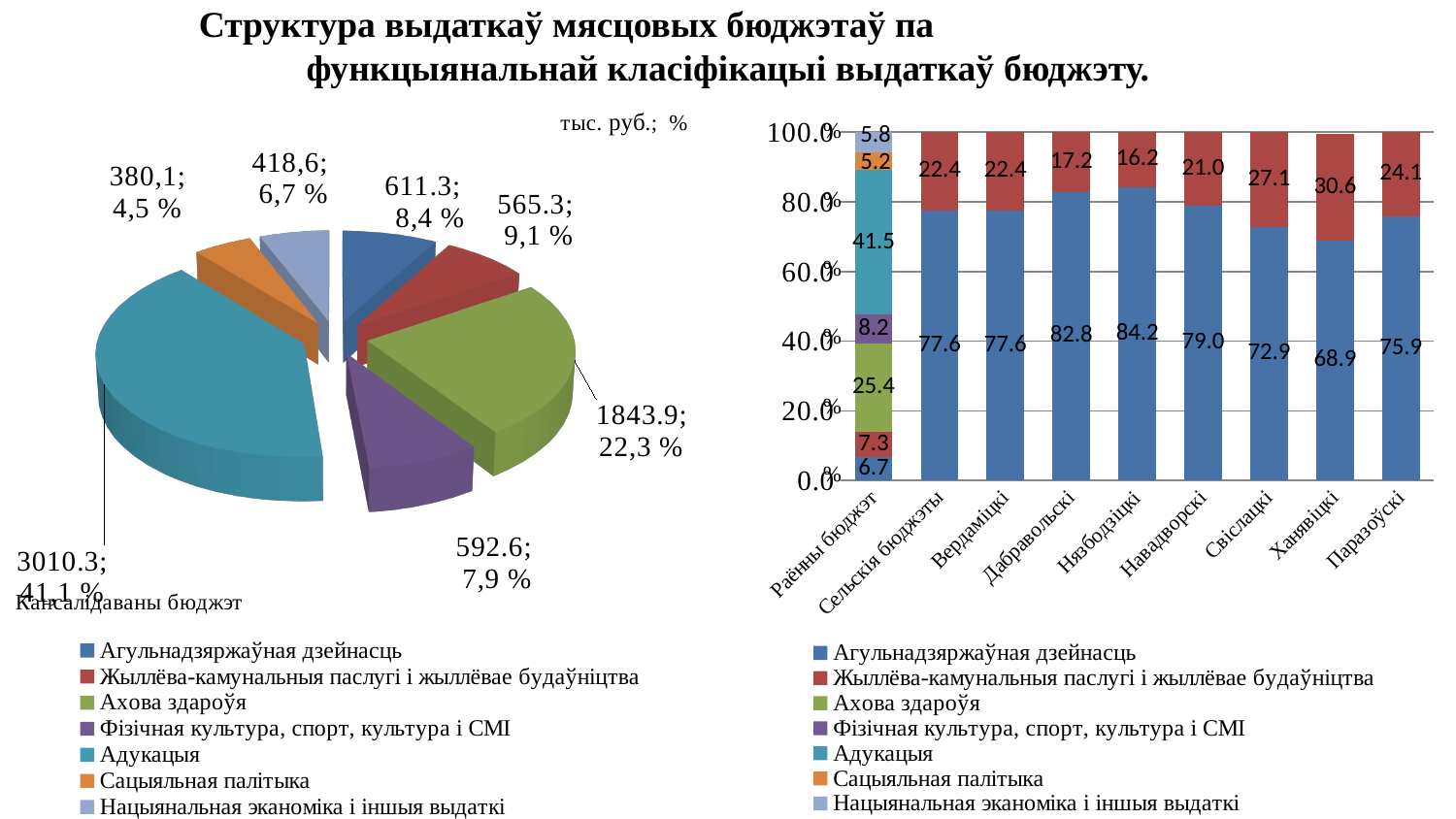
In the left pie chart, which category has the smallest slice? Сацыяльная палітыка What kind of chart is the left chart (Кансалідаваны бюджэт)? pie chart How many series does the legend of the right bar chart list? 7 In the left pie chart, what value in тыс. руб. is shown for Ахова здароўя? 1843.9 In the left pie chart, what share does Адукацыя have? 41,1 % In the right bar chart, what is the value of Агульнадзяржаўная дзейнасць for Нязбодзіцкі? 84.2 In the right bar chart, what is the value of Жыллёва-камунальныя паслугі і жыллёвае будаўніцтва for Ханявіцкі? 30.6 In the right bar chart, what is the difference between the Агульнадзяржаўная дзейнасць values for Дабравольскі and Свіслацкі? 9.9 In the right bar chart, which budget has the lowest value for Агульнадзяржаўная дзейнасць? Раённы бюджэт In the left pie chart, which category has the largest slice? Адукацыя What kind of chart is the right chart? bar chart In the right bar chart, what is the value of Адукацыя for Раённы бюджэт? 41.5